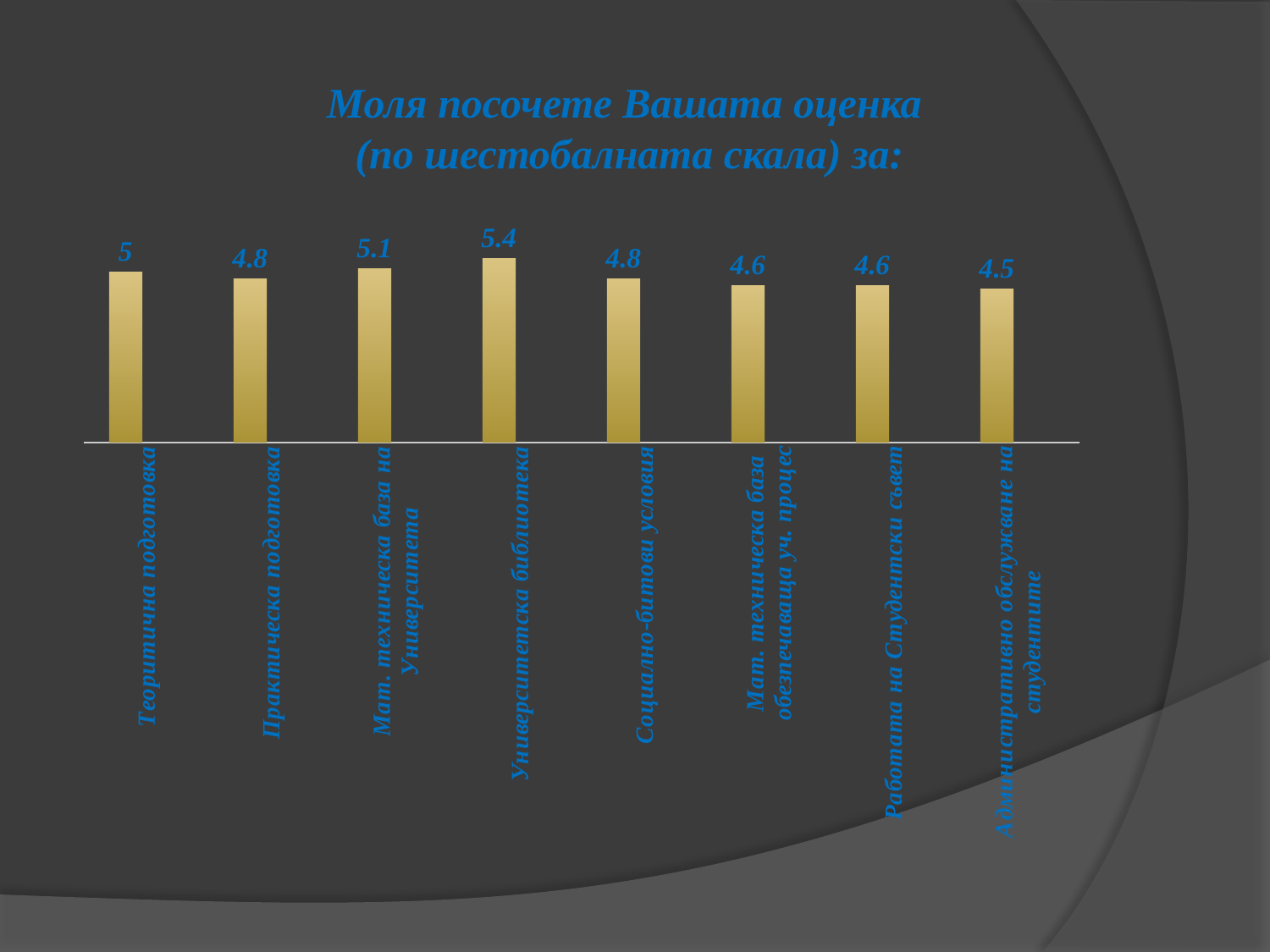
What is the value for Университетска библиотека? 5.4 What is the value for Мат. техническа база на Университета? 5.1 What kind of chart is shown on the slide? bar chart Which is larger, the value for Теоритична подготовка or the value for Работата на Студентски съвет? Теоритична подготовка How many categories are shown in the chart? 8 What is the difference between the values for Университетска библиотека and Административно обслужване на студентите? 0.9 Which category has the lowest value? Административно обслужване на студентите What is the title of the chart? Моля посочете Вашата оценка (по шестобалната скала) за: What is the difference between the values for Мат. техническа база на Университета and Практическа подготовка? 0.3 What is the value for Теоритична подготовка? 5 What is the value for Административно обслужване на студентите? 4.5 Which category has the highest value? Университетска библиотека